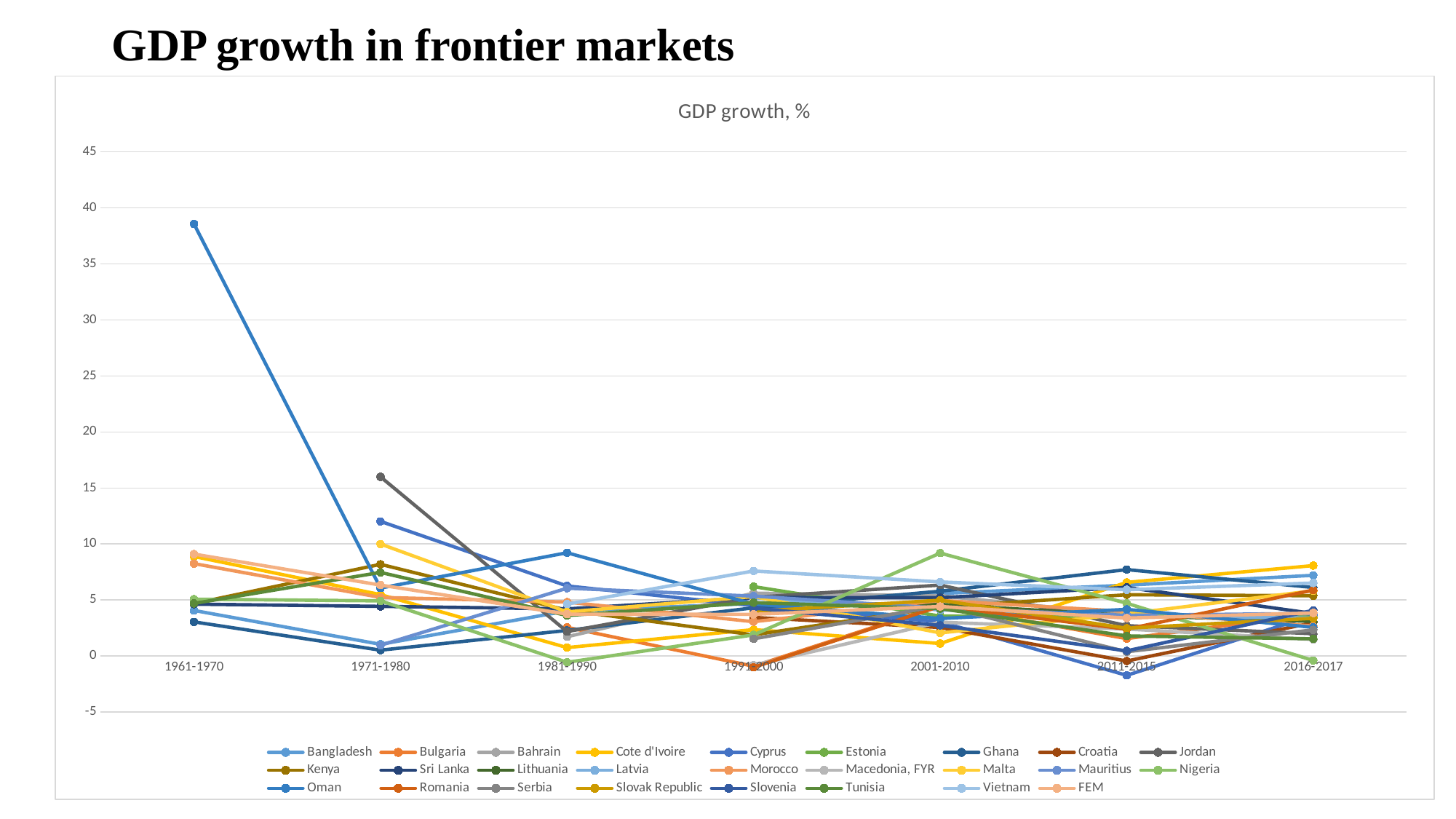
Does the highest plotted value fall or rise between 1961-1970 and 1971-1980? fall Is the lowest value plotted for 2011-2015 greater or less than 0? less How many series does the legend list? 26 In which period does the single highest value on the chart occur? 1961-1970 Is the highest value plotted for 2016-2017 greater or less than 10? less What is the title of the chart? GDP growth, % Is the highest value plotted for 1961-1970 greater or less than 35? greater What kind of chart is shown on the slide? line chart How many time periods are shown on the x axis? 7 What is the first period shown on the x axis? 1961-1970